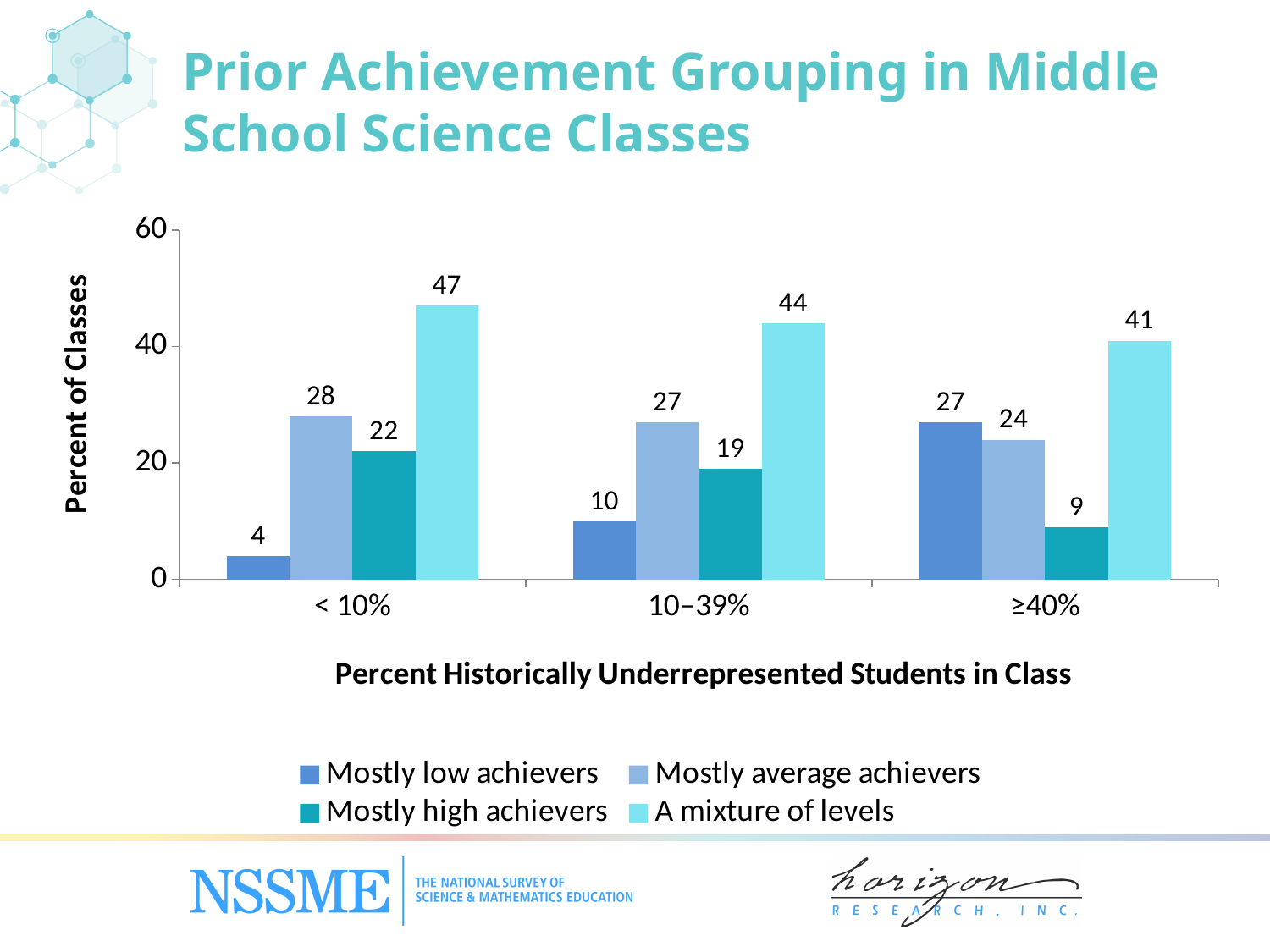
Which category has the lowest value for 'A mixture of levels'? ≥40% What is the label of the y axis? Percent of Classes What is the value for 'A mixture of levels' in the 10–39% category? 44 Do the values for 'Mostly low achievers' rise or fall from < 10% to ≥40%? Rise How many categories are shown on the x axis? 3 How many series does the legend list? 4 What kind of chart is shown on the slide? Bar chart What is the difference between the 'A mixture of levels' value and the 'Mostly low achievers' value in the < 10% category? 43 In the ≥40% category, which is larger: 'Mostly low achievers' or 'Mostly average achievers'? Mostly low achievers Which category has the highest value for 'Mostly low achievers'? ≥40% What is the value for 'Mostly high achievers' in the ≥40% category? 9 What percent of classes with < 10% historically underrepresented students are grouped as mostly low achievers? 4